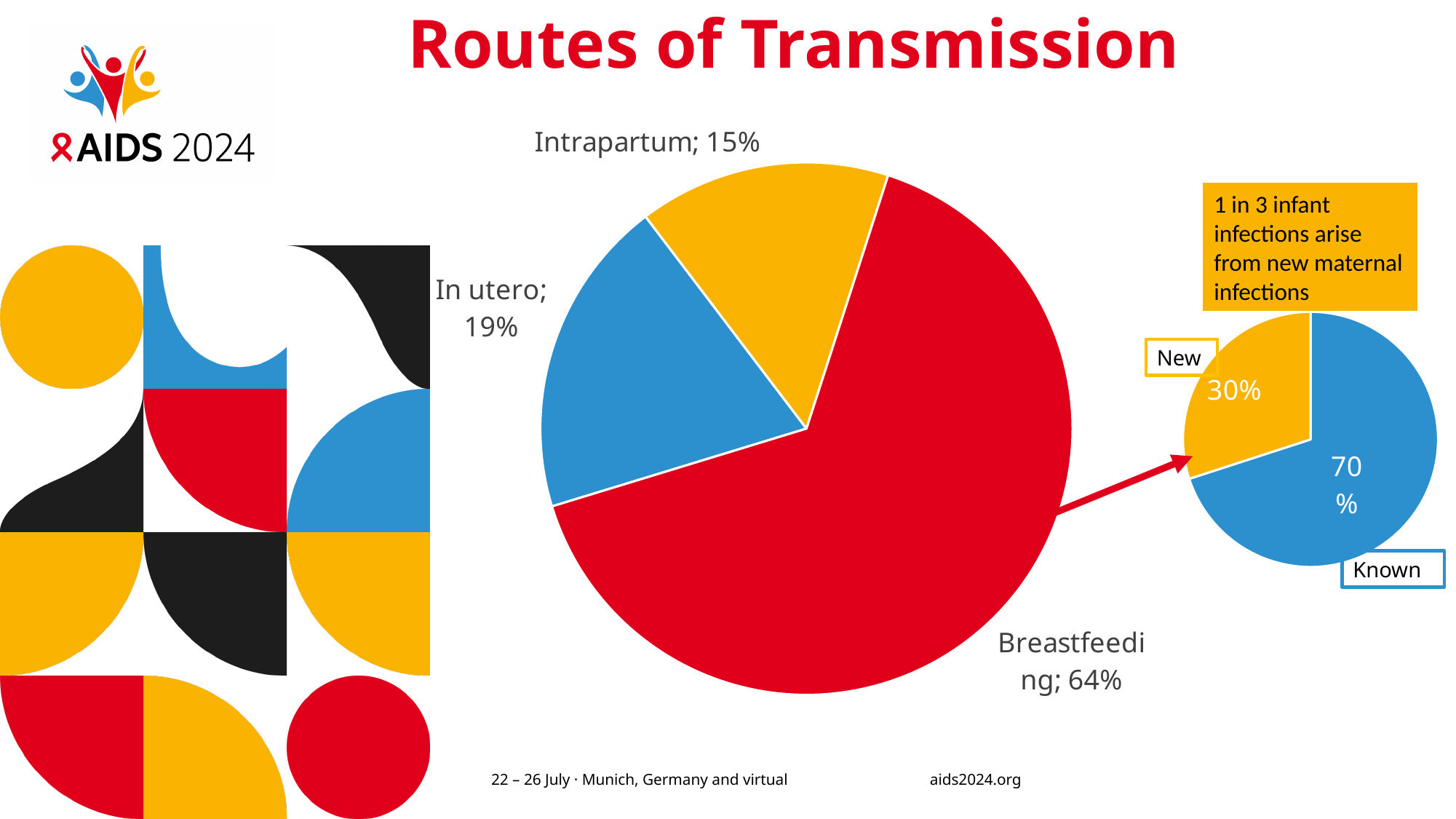
In the small pie chart on the right, what share is labelled Known? 70% How many slices does the large pie chart have? 3 In the large pie chart, which route of transmission has the smallest share? Intrapartum In the large pie chart, what is the difference in percentage points between Breastfeeding and In utero? 45 In the large pie chart, which route of transmission has the largest share? Breastfeeding In the large pie chart, which is larger, In utero or Intrapartum? In utero In the large pie chart, what share is labelled for In utero? 19% What kind of chart is the large chart in the centre of the slide? Pie chart In the small pie chart on the right, which slice is larger, New or Known? Known In the large pie chart, what share is labelled for Intrapartum? 15% In the large pie chart, what share is labelled for Breastfeeding? 64% In the small pie chart on the right, what share is labelled New? 30%